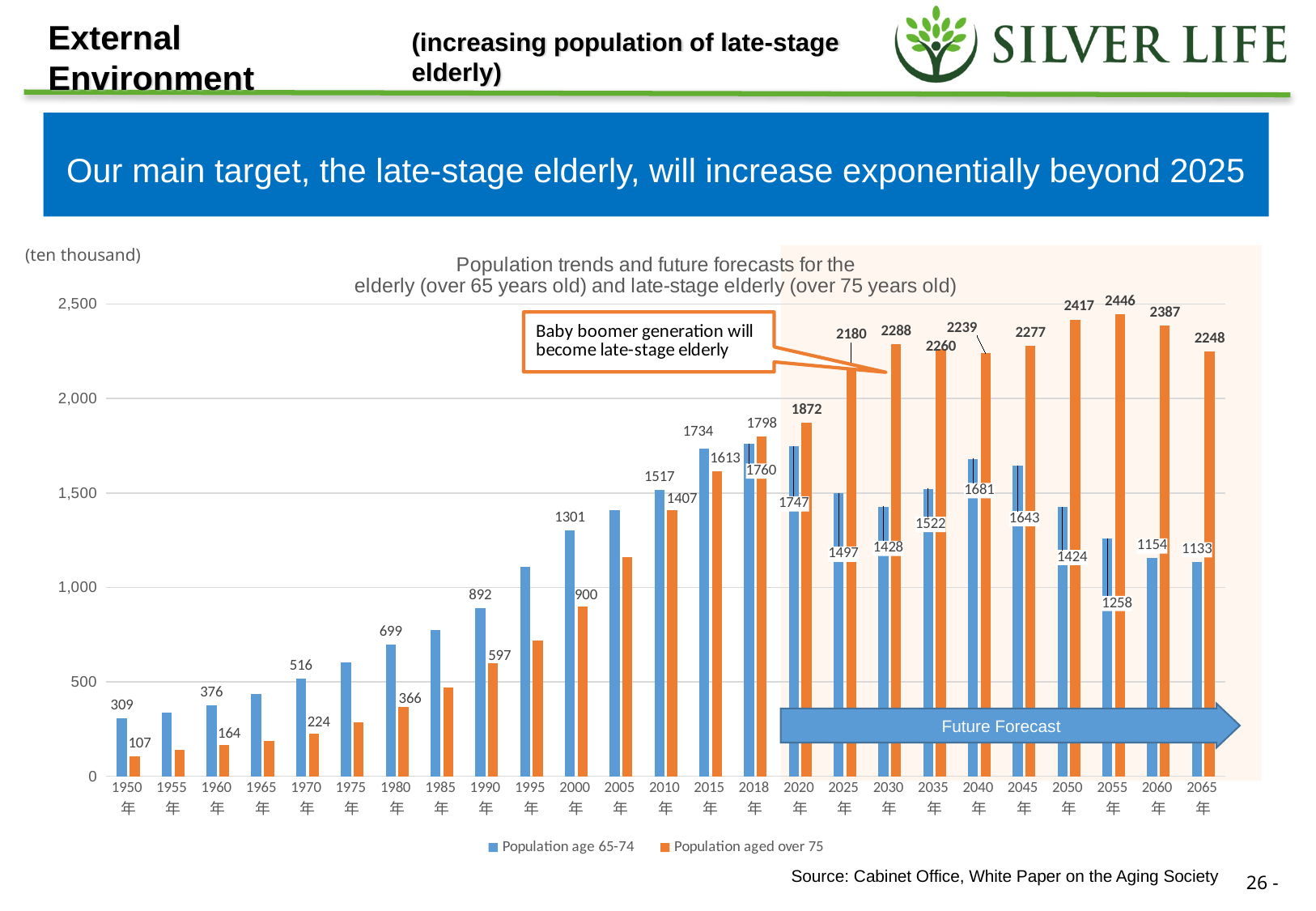
What is the value for Population age 65-74 in 2000? 1301 How many years are shown on the x axis? 25 How many series does the legend list? 2 What unit is stated for the values on the chart? ten thousand In which year is the Population aged over 75 highest? 2055 What kind of chart is shown on the slide? bar chart What is the value for Population aged over 75 in 2025? 2180 Does the Population aged over 75 rise or fall from 1950 to 2055? rise What is the difference between the Population aged over 75 in 2055 and in 2050? 29 In which year is the Population aged over 75 lowest? 1950 Is the value for Population age 65-74 in 1975 greater or less than 500? greater In 2020, which is larger: Population age 65-74 or Population aged over 75? Population aged over 75